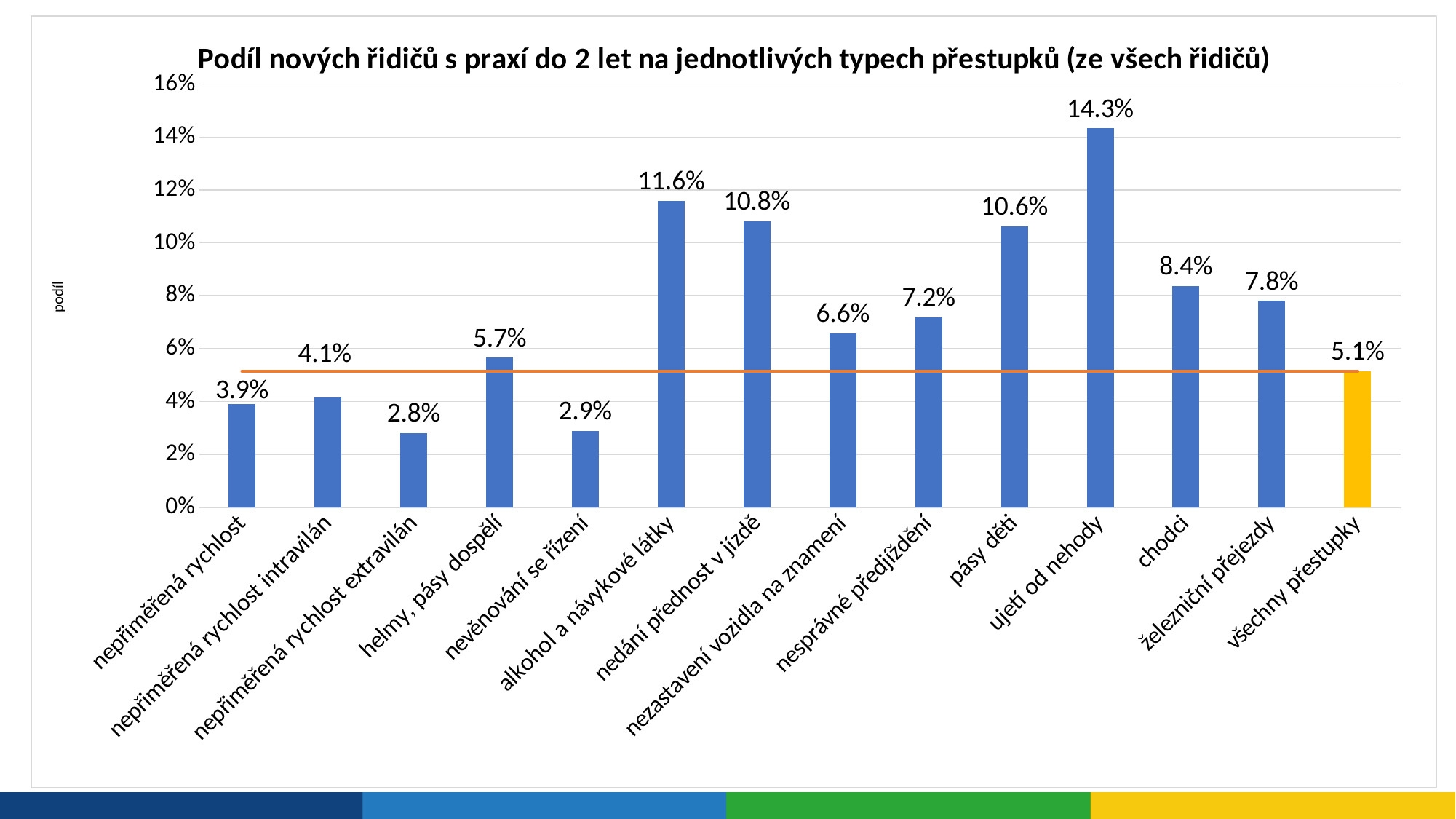
What kind of chart is shown on the slide? combination bar and line chart What is the value for 'pásy děti'? 10.6% Which category has the highest value? ujetí od nehody Is the value for 'železniční přejezdy' greater or less than 6%? greater How many categories are shown on the x axis? 14 Which category has the lowest value? nepřiměřená rychlost extravilán What is the value for 'alkohol a návykové látky'? 11.6% Which bar is coloured differently (yellow) from the others? všechny přestupky What is the difference between the values for 'ujetí od nehody' and 'chodci'? 5.9% What is the value for 'všechny přestupky'? 5.1% Which is larger, the value for 'nedání přednost v jízdě' or the value for 'pásy děti'? nedání přednost v jízdě What is the value for 'ujetí od nehody'? 14.3%